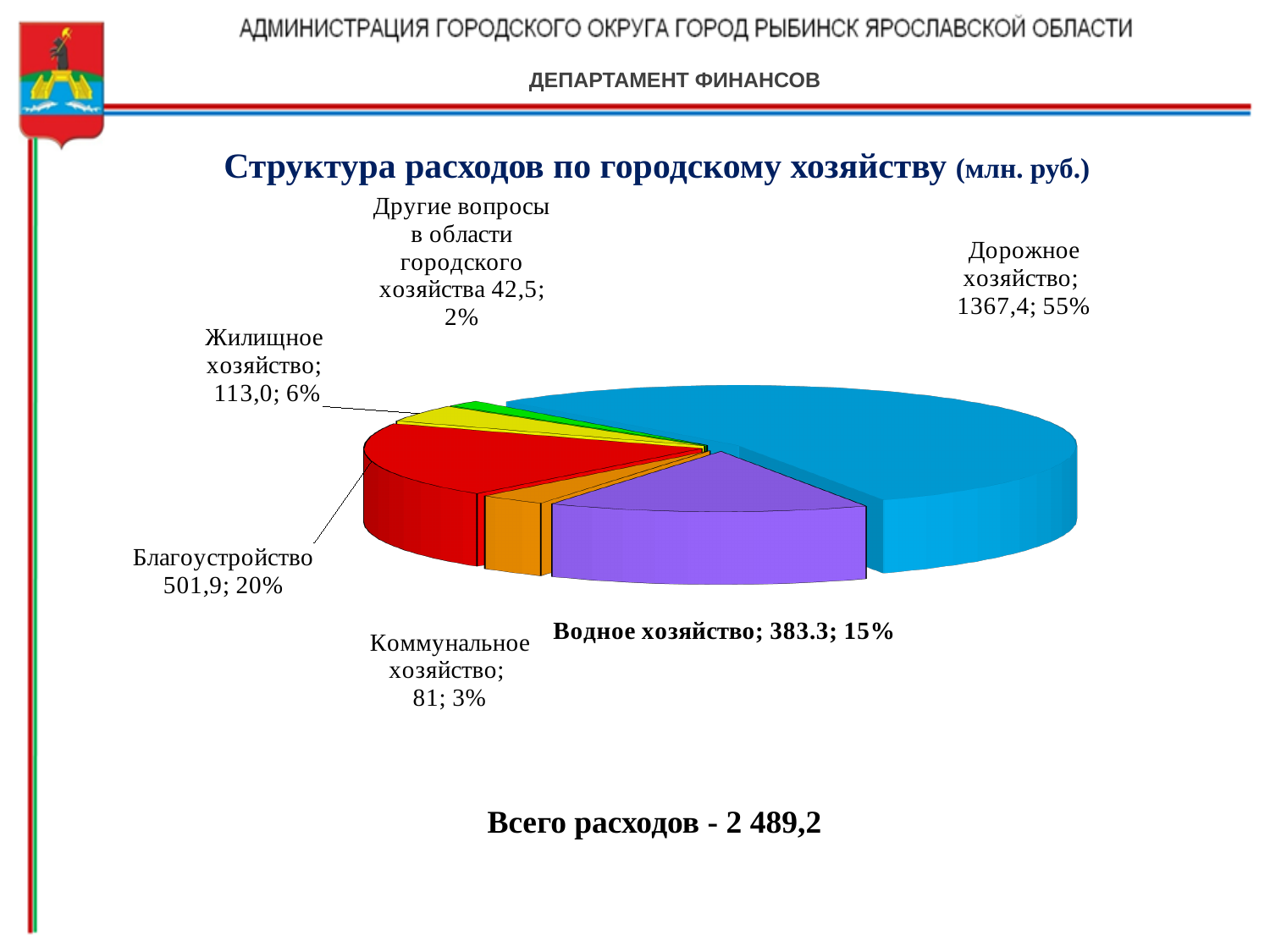
Какая категория имеет наибольшее значение? Дорожное хозяйство Какова общая сумма расходов, указанная на слайде? 2 489,2 Какое значение указано для категории «Благоустройство»? 501,9 Какая категория имеет наименьшее значение? Другие вопросы в области городского хозяйства Какая доля приходится на «Водное хозяйство»? 15% Что больше: «Водное хозяйство» или «Благоустройство»? Благоустройство Какое значение указано для категории «Дорожное хозяйство»? 1367,4 Какая доля приходится на «Жилищное хозяйство»? 6% Сколько категорий показано на диаграмме? 6 На сколько значение «Благоустройство» больше значения «Жилищное хозяйство»? 388,9 Какой тип диаграммы показан на слайде? Круговая диаграмма Какое значение указано для категории «Коммунальное хозяйство»? 81